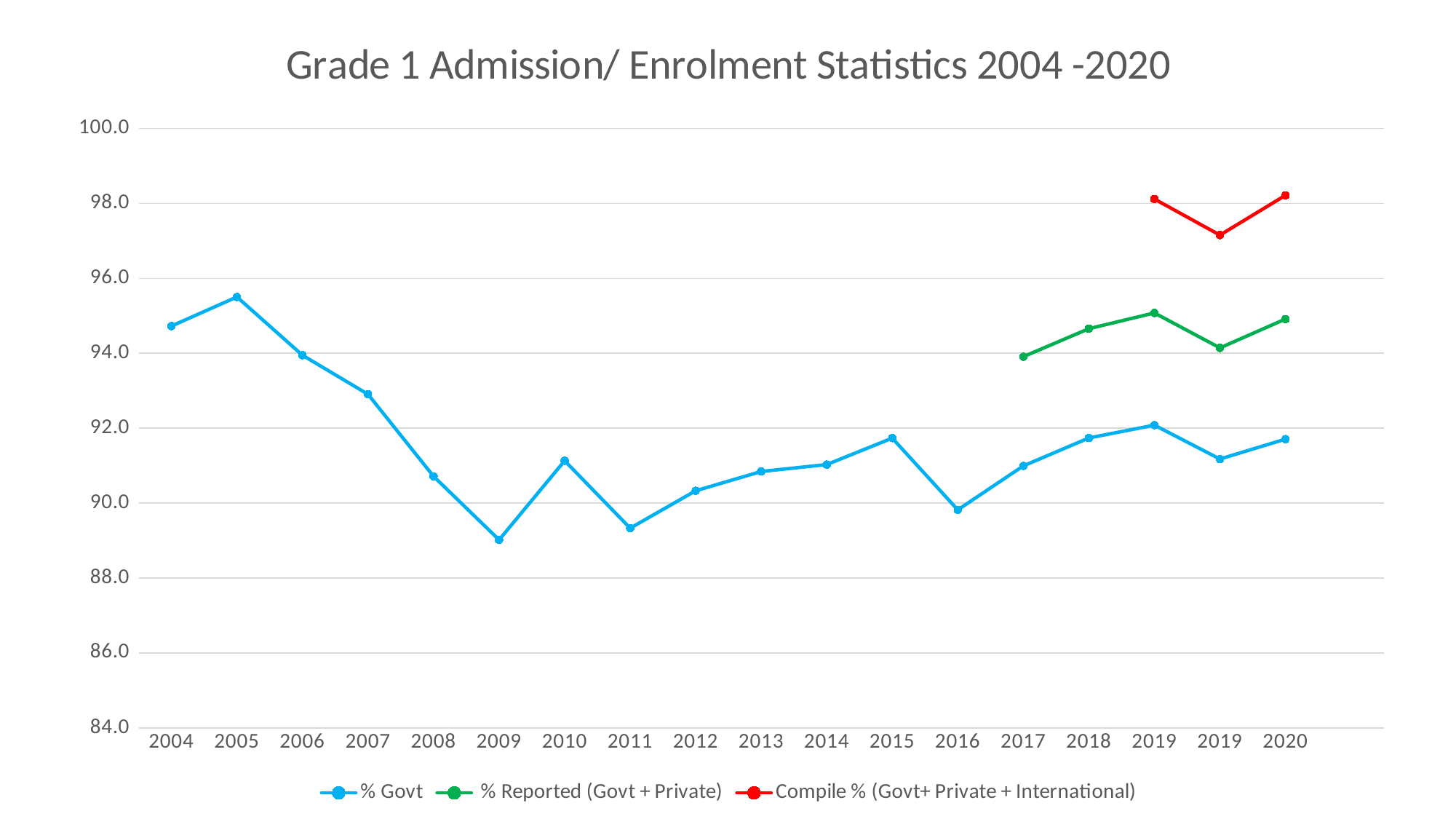
In which year does the % Govt series reach its lowest value? 2009 Does the % Govt series rise or fall from 2005 to 2009? Falls What is the title of the chart? Grade 1 Admission/ Enrolment Statistics 2004 -2020 Is the % Govt value for 2004 greater or less than 94.0? greater What type of chart is shown on the slide? Line chart How many series does the legend list? 3 In which year does the % Govt series reach its highest value? 2005 Which year has the higher % Govt value, 2005 or 2006? 2005 How many data points does the Compile % (Govt+ Private + International) series have? 3 Is the % Govt value for 2009 greater or less than 90.0? less Is the Compile % (Govt+ Private + International) value for 2020 greater or less than 96.0? greater